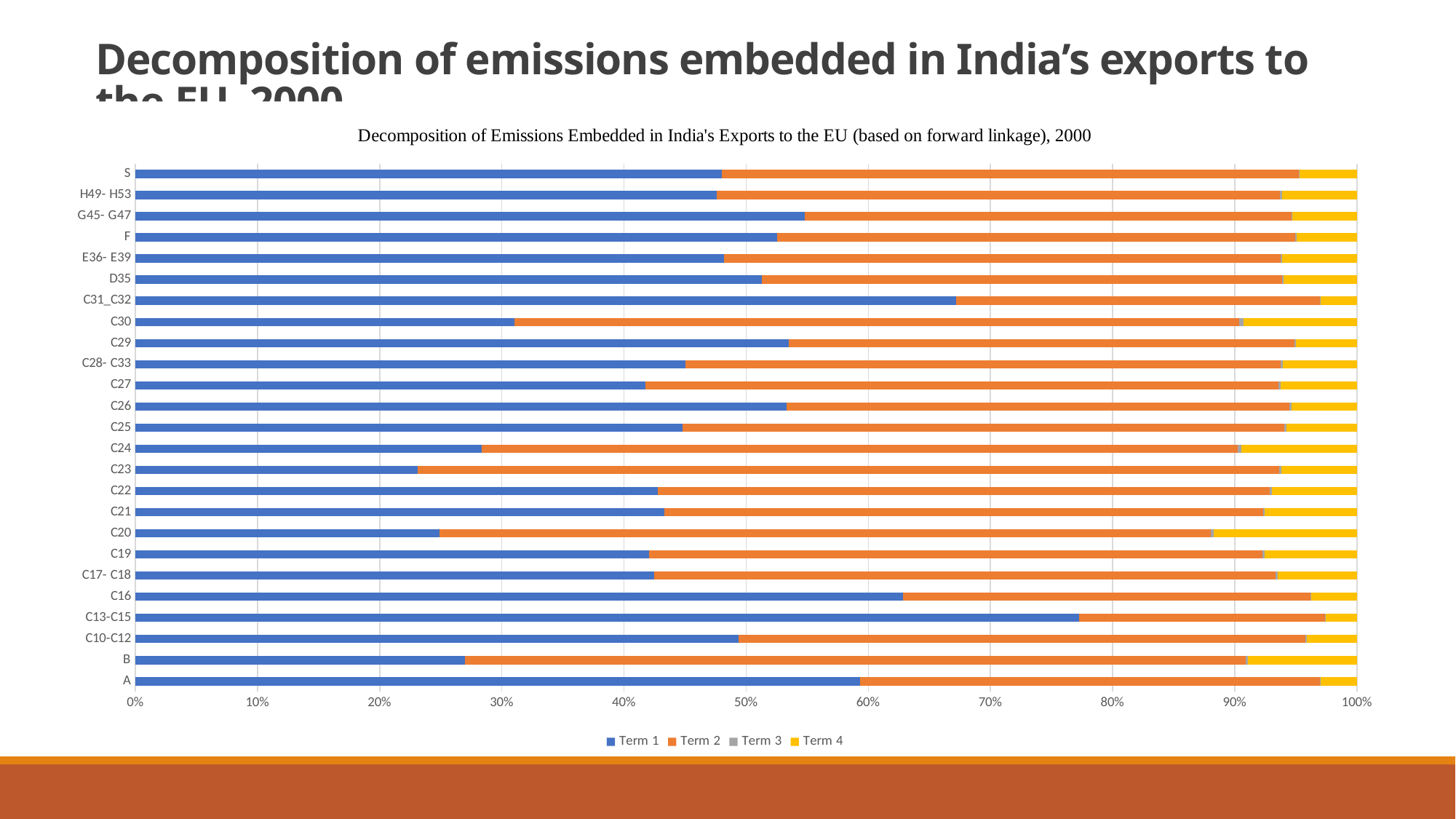
How many categories are plotted on the vertical axis? 25 Is the Term 1 share for C23 greater or less than 30%? less What kind of chart is shown on the slide? bar chart What is the title printed above the chart? Decomposition of Emissions Embedded in India's Exports to the EU (based on forward linkage), 2000 Is the Term 1 share for C13-C15 greater or less than 70%? greater Which has the larger Term 1 share, C16 or C24? C16 Is the Term 1 share for C20 greater or less than 40%? less How many series does the legend list? 4 Which category has the largest Term 1 share? C13-C15 What are the four series named in the legend? Term 1, Term 2, Term 3, Term 4 Which has the larger Term 1 share, A or B? A